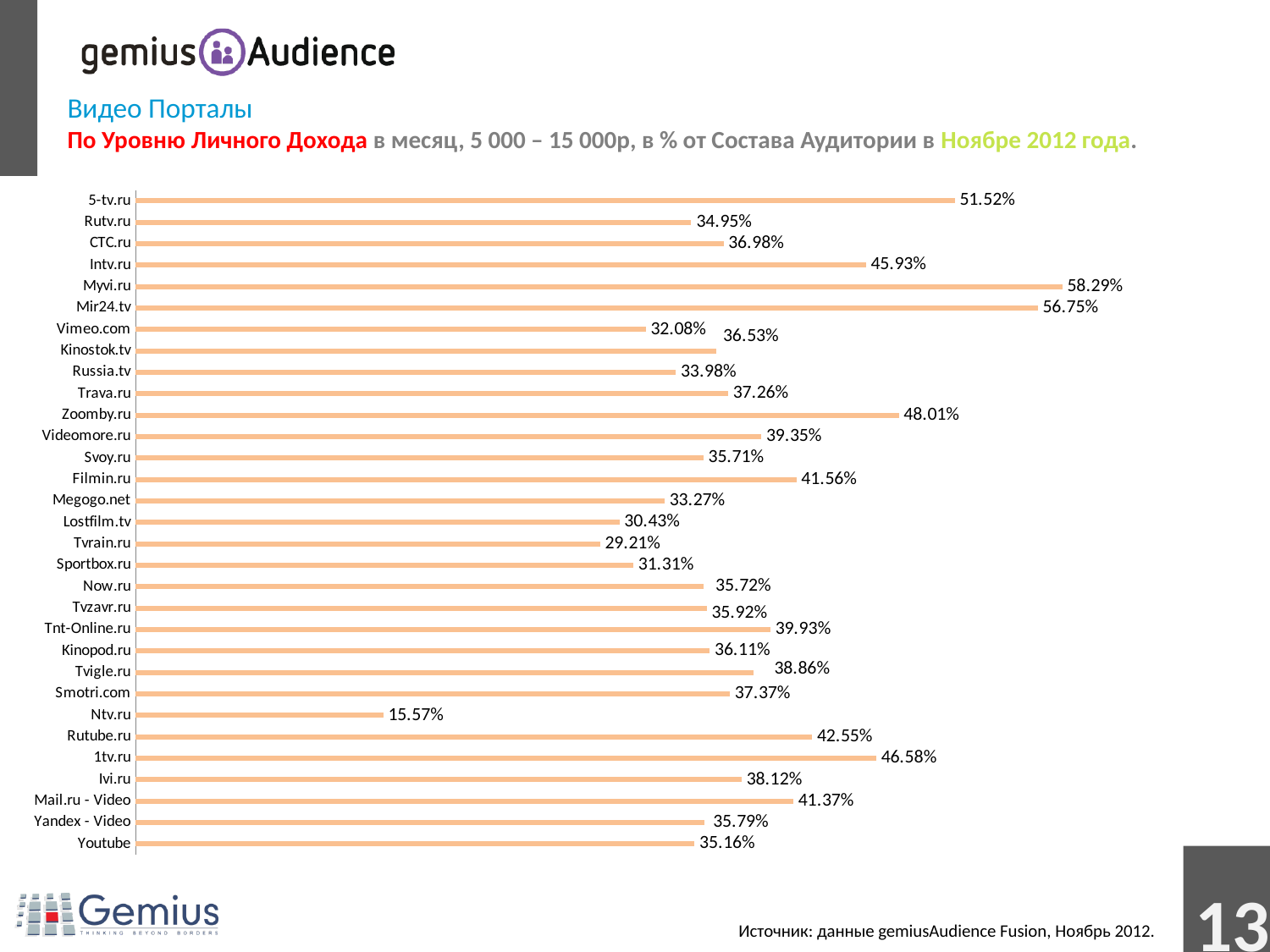
What is the value for Myvi.ru? 58.29% Which video portal has the highest value? Myvi.ru Which has a larger value, Rutube.ru or 1tv.ru? 1tv.ru What is the value for Youtube? 35.16% What kind of chart is shown on the slide? Bar chart What is the value for Mail.ru - Video? 41.37% Which has a larger value, Tvrain.ru or Lostfilm.tv? Lostfilm.tv What is the value for Zoomby.ru? 48.01% What is the difference between the values for Myvi.ru and Mir24.tv? 1.54% Which video portal has the lowest value? Ntv.ru How many video portals are shown in the chart? 31 What is the difference between the values for 5-tv.ru and Ntv.ru? 35.95%